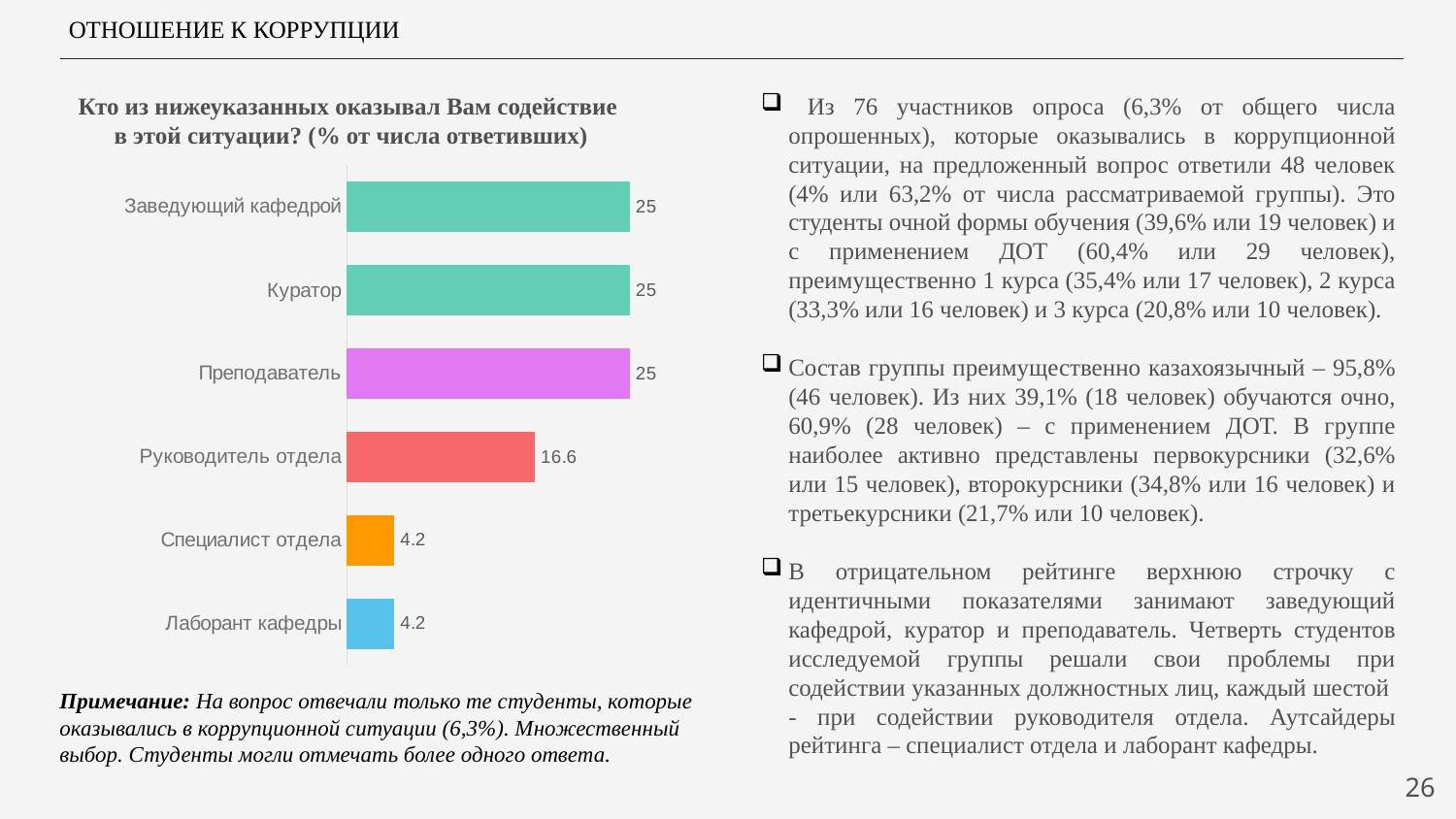
What is the highest value shown on the chart? 25 What kind of chart is shown on the slide? Bar chart What is the difference between the values for Преподаватель and Руководитель отдела? 8.4 What is the difference between the values for Руководитель отдела and Лаборант кафедры? 12.4 How many categories are shown on the chart? 6 What value is shown for Специалист отдела? 4.2 What is the lowest value shown on the chart? 4.2 What value is shown for Руководитель отдела? 16.6 What value is shown for Заведующий кафедрой? 25 What value is shown for Куратор? 25 Which has a larger value, Руководитель отдела or Специалист отдела? Руководитель отдела What colour is the bar for Преподаватель? Purple